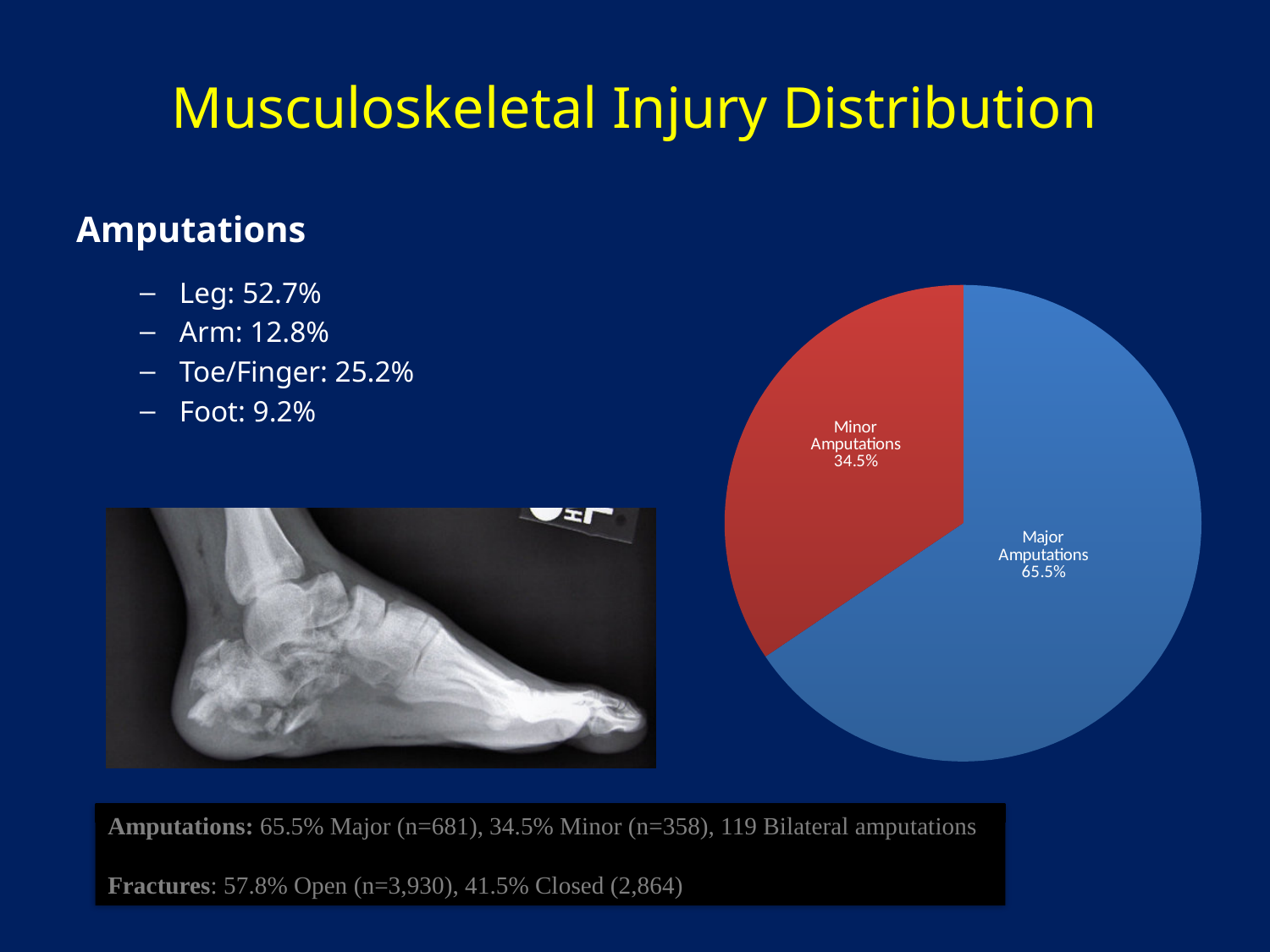
What share of the pie chart is Minor Amputations? 34.5% Which slice of the pie chart is the largest? Major Amputations What is the difference in percentage points between the Major Amputations and Minor Amputations slices? 31.0 percentage points What kind of chart is shown on the slide? pie chart What colour is the Major Amputations slice in the pie chart? blue Is the share for Minor Amputations greater or less than 50%? less Which slice of the pie chart is the smallest? Minor Amputations Which is larger in the pie chart, Major Amputations or Minor Amputations? Major Amputations What colour is the Minor Amputations slice in the pie chart? red How many slices does the pie chart have? 2 What share of the pie chart is Major Amputations? 65.5%